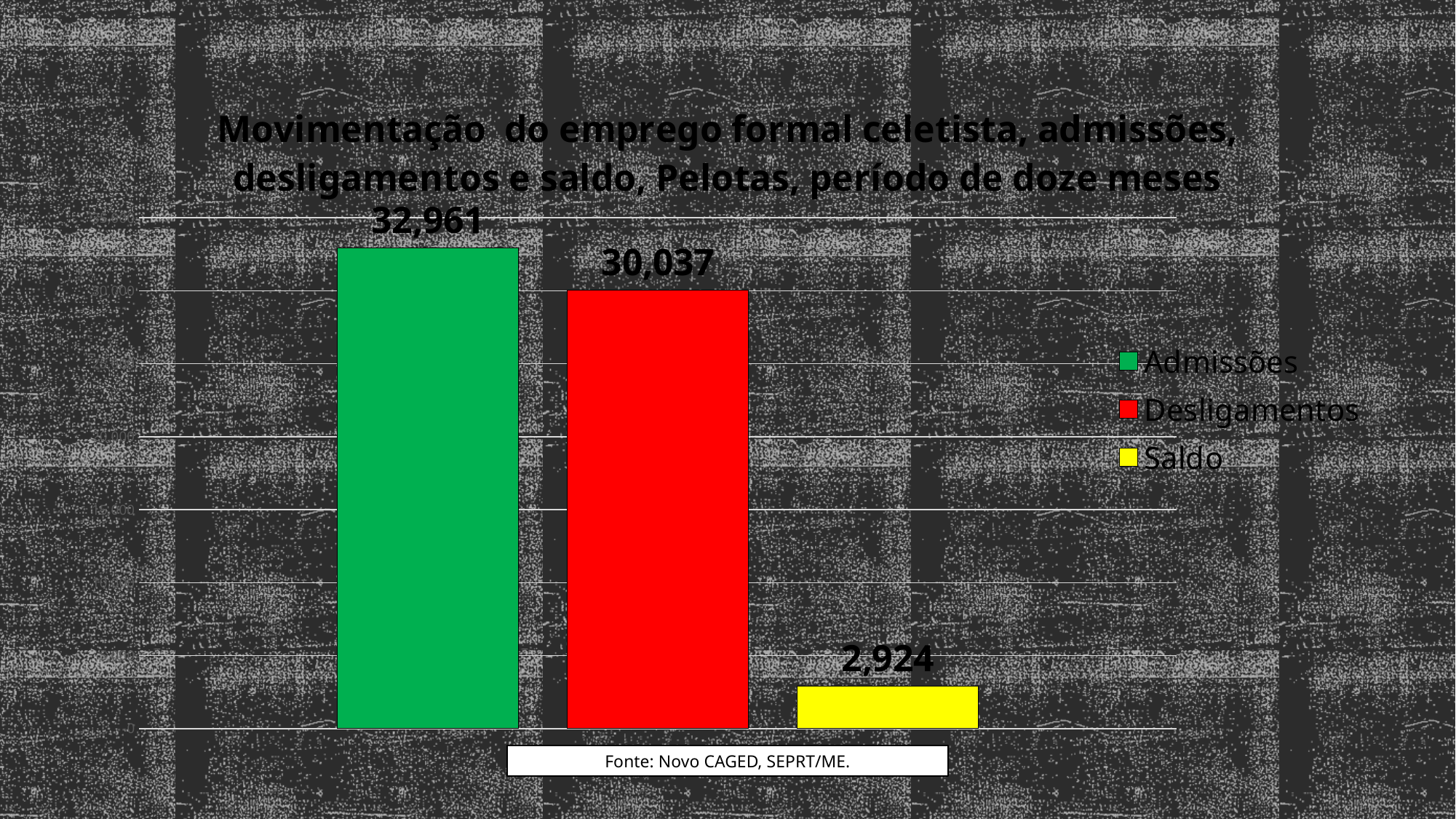
What is the value shown for Saldo? 2,924 How many bars are plotted in the chart? 3 What is the value shown for Admissões? 32,961 Which series has the lowest value? Saldo What colour is the bar for Saldo? Yellow Which is larger, Admissões or Desligamentos? Admissões Which series has the highest value? Admissões What is the difference between Admissões and Desligamentos? 2,924 What kind of chart is shown on the slide? Bar chart What is the difference between Desligamentos and Saldo? 27,113 What is the value shown for Desligamentos? 30,037 How many series does the legend list? 3